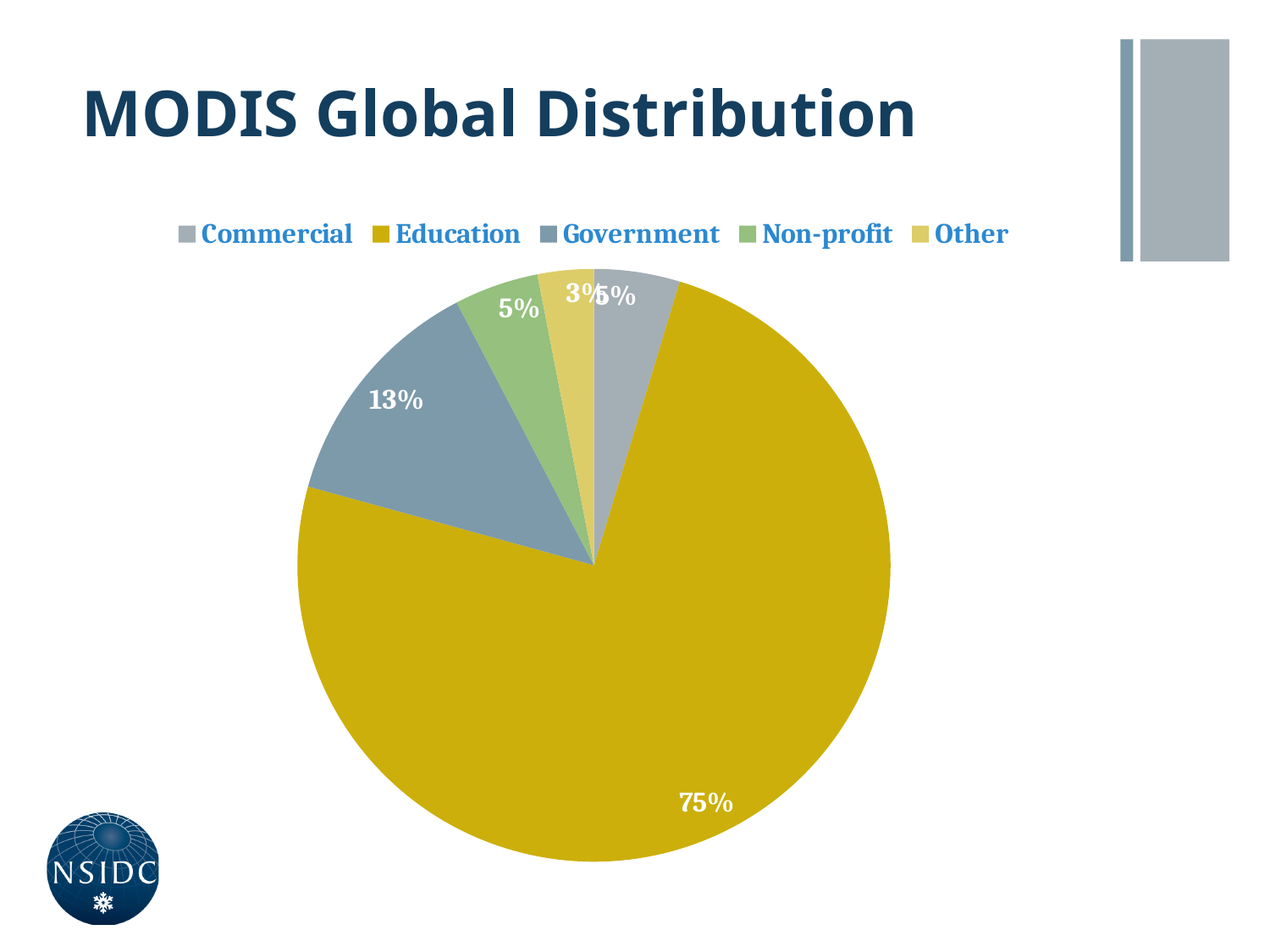
What percentage is shown for Non-profit? 5% How many percentage points larger is Education than Government? 62% How many categories does the pie chart show? 5 What kind of chart is shown on the slide? Pie chart Which is larger, the Government slice or the Non-profit slice? Government What is the title of the slide containing the pie chart? MODIS Global Distribution Which category has the smallest slice of the pie? Other Which category has the largest slice of the pie? Education What share of the pie does Education account for? 75% What percentage is shown for Other? 3% What percentage is shown for Government? 13% Which category is listed first in the legend? Commercial